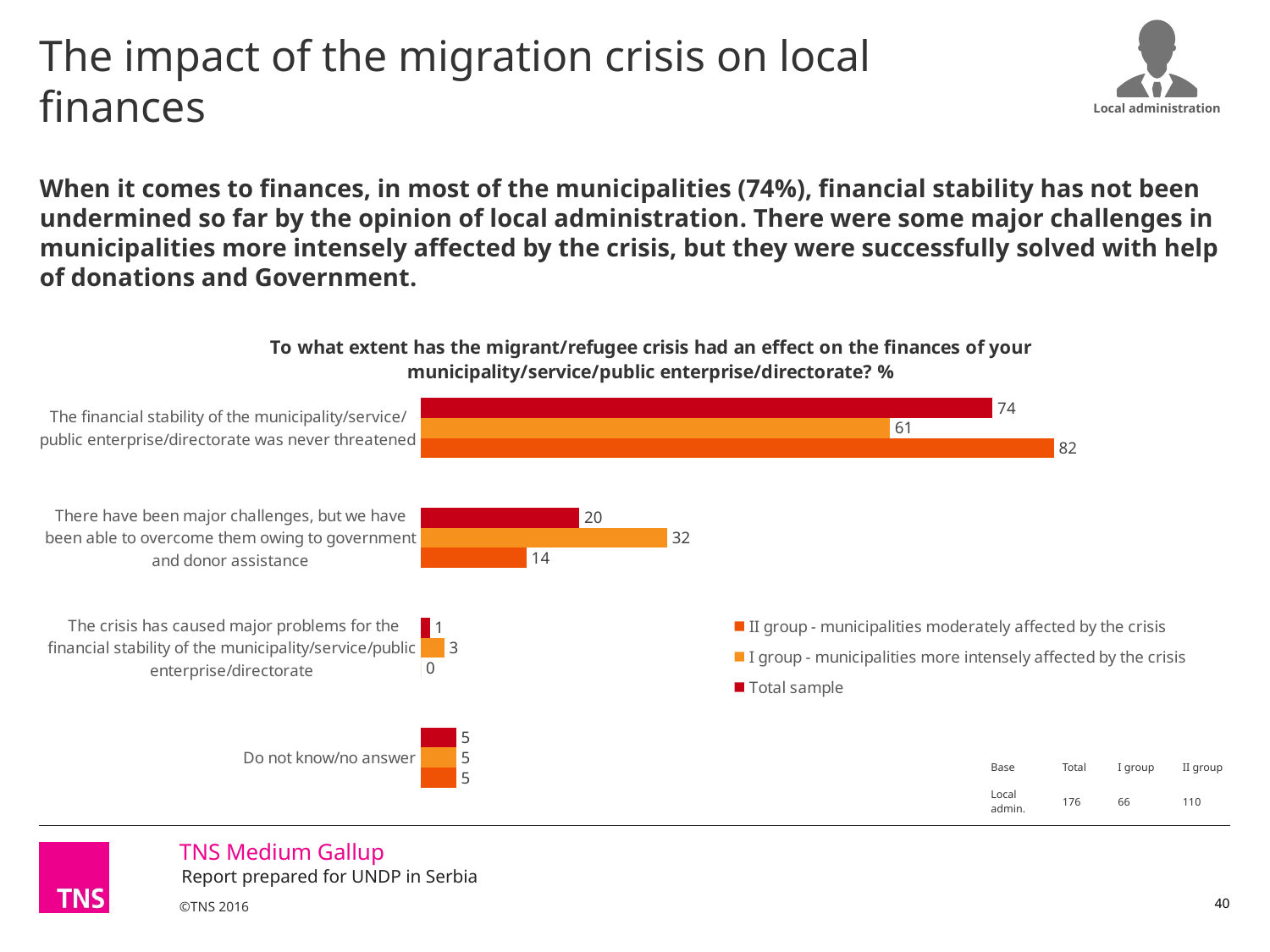
How many response categories are shown in the chart? 4 What is the value for II group for "The crisis has caused major problems for the financial stability of the municipality/service/public enterprise/directorate"? 0 Which response category has the highest Total sample value? The financial stability of the municipality/service/public enterprise/directorate was never threatened For "There have been major challenges, but we have been able to overcome them...", which is larger: the I group value or the II group value? I group What is the value for all three series for "Do not know/no answer"? 5 What is the value for I group - municipalities more intensely affected by the crisis for "There have been major challenges, but we have been able to overcome them owing to government and donor assistance"? 32 How many series does the legend list? 3 Which response category has the lowest Total sample value? The crisis has caused major problems for the financial stability of the municipality/service/public enterprise/directorate What is the Total sample value for "The financial stability of the municipality/service/public enterprise/directorate was never threatened"? 74 What is the difference between the II group and I group values for "The financial stability ... was never threatened"? 21 What kind of chart is shown on the slide? Bar chart What is the value for II group - municipalities moderately affected by the crisis for "The financial stability of the municipality/service/public enterprise/directorate was never threatened"? 82